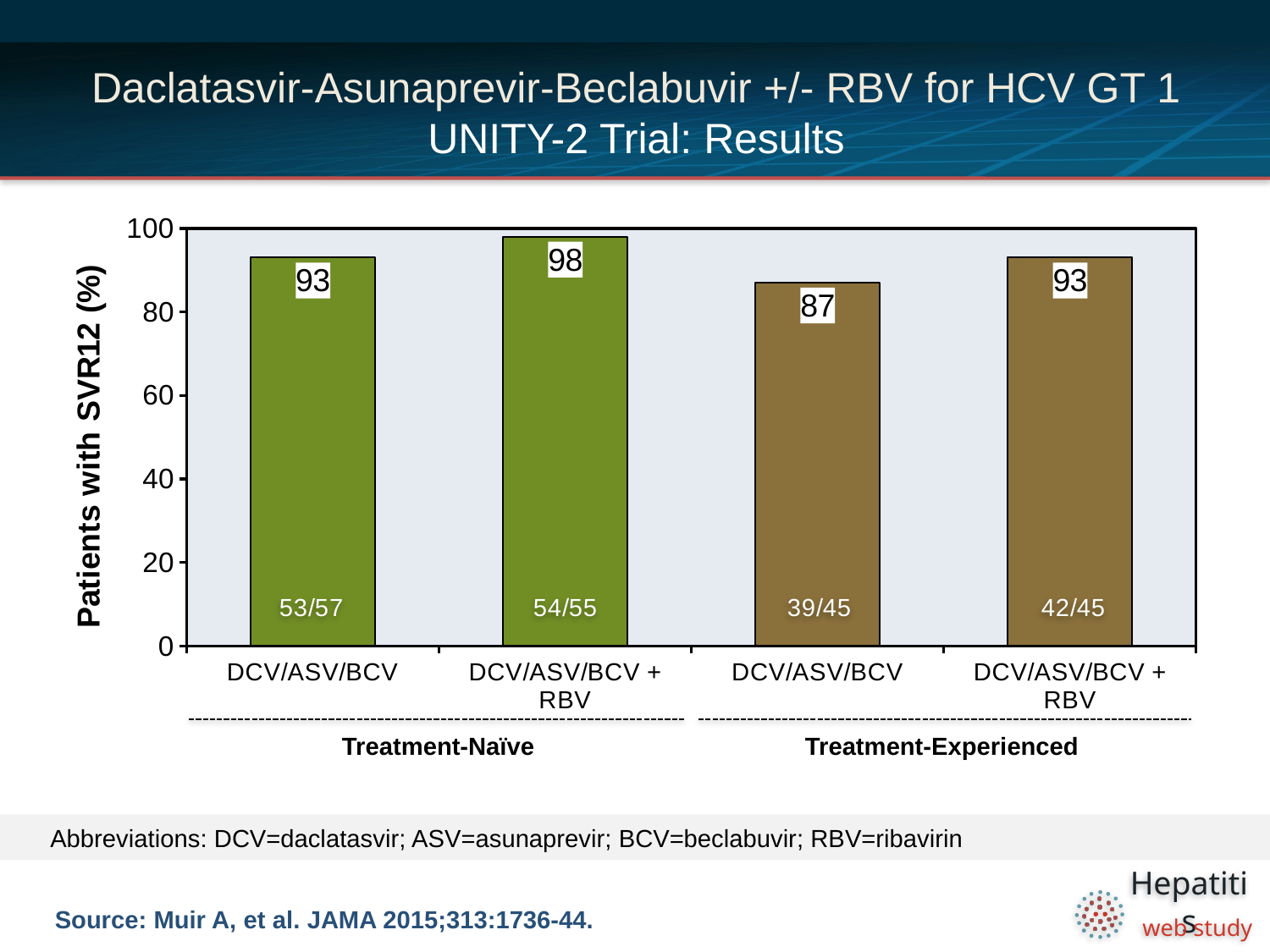
Is the SVR12 rate for the Treatment-Experienced DCV/ASV/BCV arm greater or less than 80? greater Which bar has the lowest SVR12 rate? DCV/ASV/BCV (Treatment-Experienced) Which bar has the highest SVR12 rate? DCV/ASV/BCV + RBV (Treatment-Naïve) What is the difference in SVR12 rate between the Treatment-Naïve DCV/ASV/BCV + RBV arm and the Treatment-Experienced DCV/ASV/BCV arm? 11 How many bars are shown in the chart? 4 What is the SVR12 rate for DCV/ASV/BCV in the Treatment-Experienced group? 87 Which has a higher SVR12 rate: Treatment-Naïve DCV/ASV/BCV or Treatment-Experienced DCV/ASV/BCV? Treatment-Naïve DCV/ASV/BCV What type of chart is shown on the slide? Bar chart What is the SVR12 rate for DCV/ASV/BCV + RBV in the Treatment-Naïve group? 98 What is the SVR12 rate for DCV/ASV/BCV in the Treatment-Naïve group? 93 What is the label of the y-axis? Patients with SVR12 (%) How many patients achieved SVR12 out of the total in the Treatment-Experienced DCV/ASV/BCV + RBV arm? 42/45